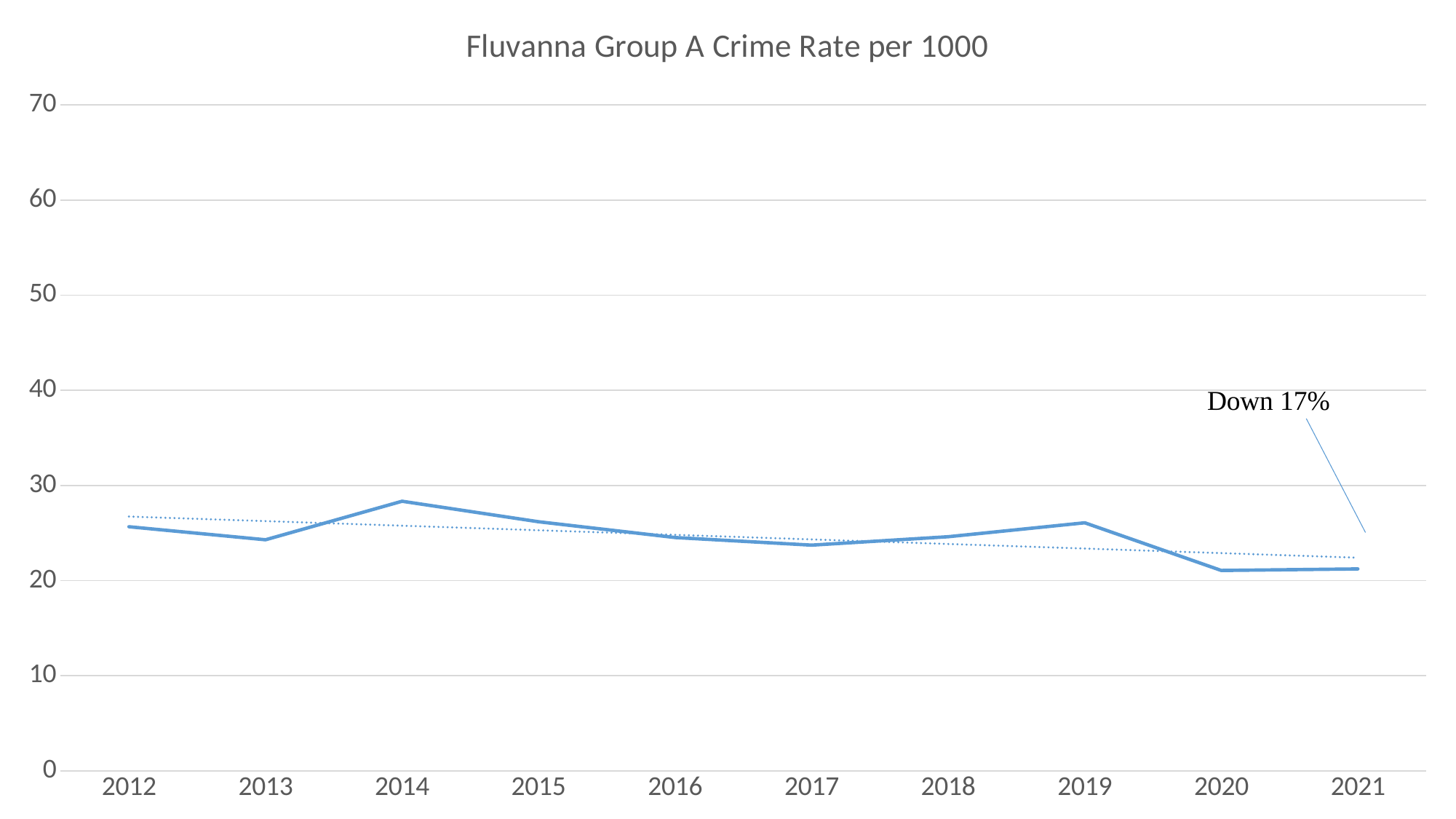
Is the value for 2020 greater or less than 20? greater Is the value for 2014 greater or less than 30? less How many years are plotted along the x axis? 10 Which is larger, the value for 2019 or the value for 2017? 2019 Does the crime rate generally rise or fall from 2012 to 2021? fall Which is larger, the value for 2014 or the value for 2015? 2014 What does the annotation near the 2021 point say? Down 17% What is the title of the chart? Fluvanna Group A Crime Rate per 1000 Which is larger, the value for 2014 or the value for 2020? 2014 Which year has the highest crime rate on the chart? 2014 Is the value for 2012 greater or less than 30? less What kind of chart is shown on the slide? line chart